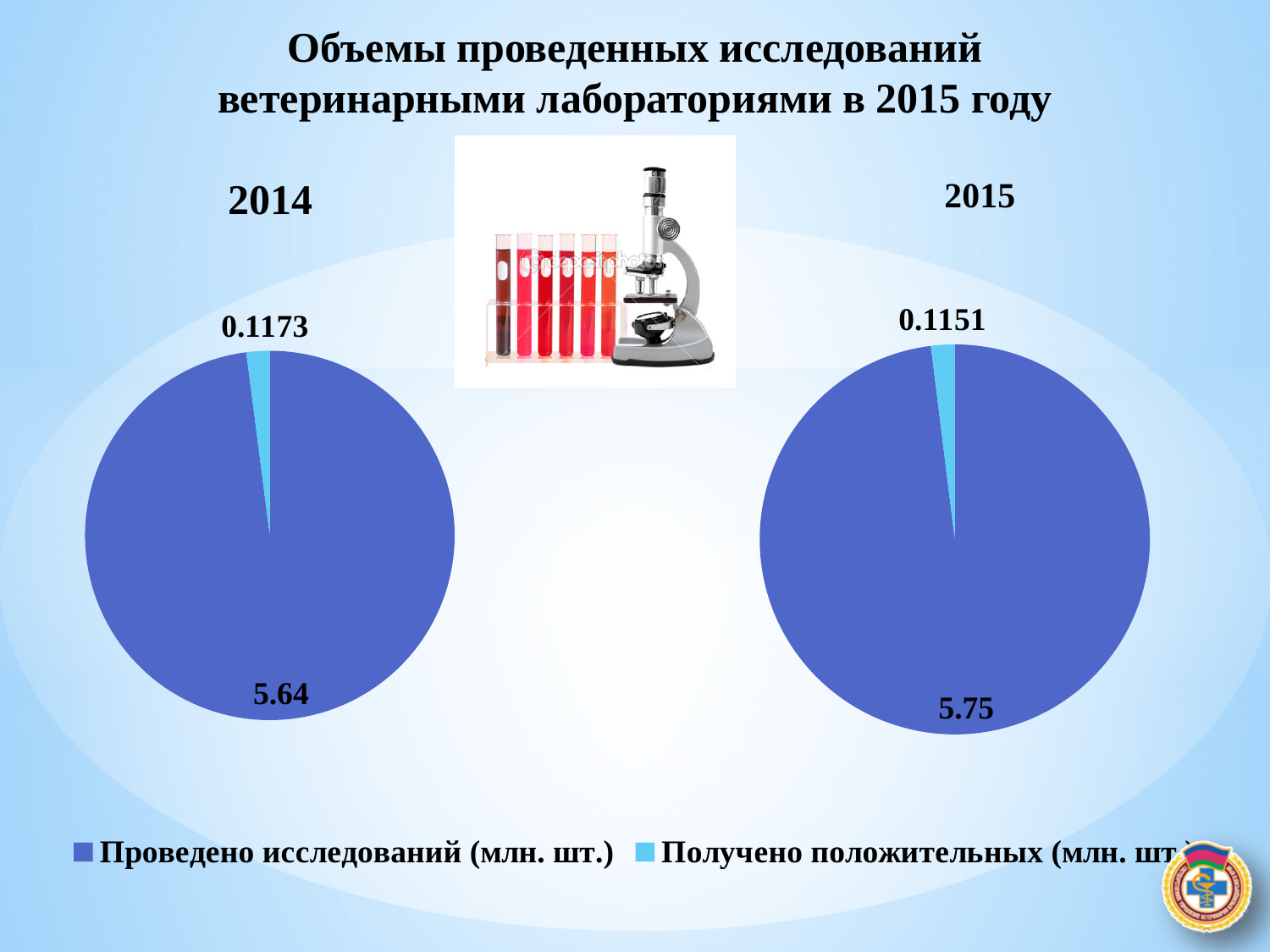
In the 2014 pie chart, what is the value for Проведено исследований (млн. шт.)? 5.64 In the 2014 pie chart, which category has the smallest slice? Получено положительных (млн. шт.) In the 2015 pie chart, which category has the largest slice? Проведено исследований (млн. шт.) How many entries does the legend list? 2 What is the difference between the two values shown in the 2015 pie chart? 5.6349 What is the difference between the two values shown in the 2014 pie chart? 5.5227 In the 2014 pie chart, what is the value for Получено положительных (млн. шт.)? 0.1173 In the 2015 pie chart, what is the value for Проведено исследований (млн. шт.)? 5.75 In the 2015 pie chart, what is the value for Получено положительных (млн. шт.)? 0.1151 Which is larger: the value for Проведено исследований in the 2014 chart or in the 2015 chart? 2015 What type of chart is used for the 2014 and 2015 data on this slide? Pie chart How many slices does the 2014 pie chart have? 2